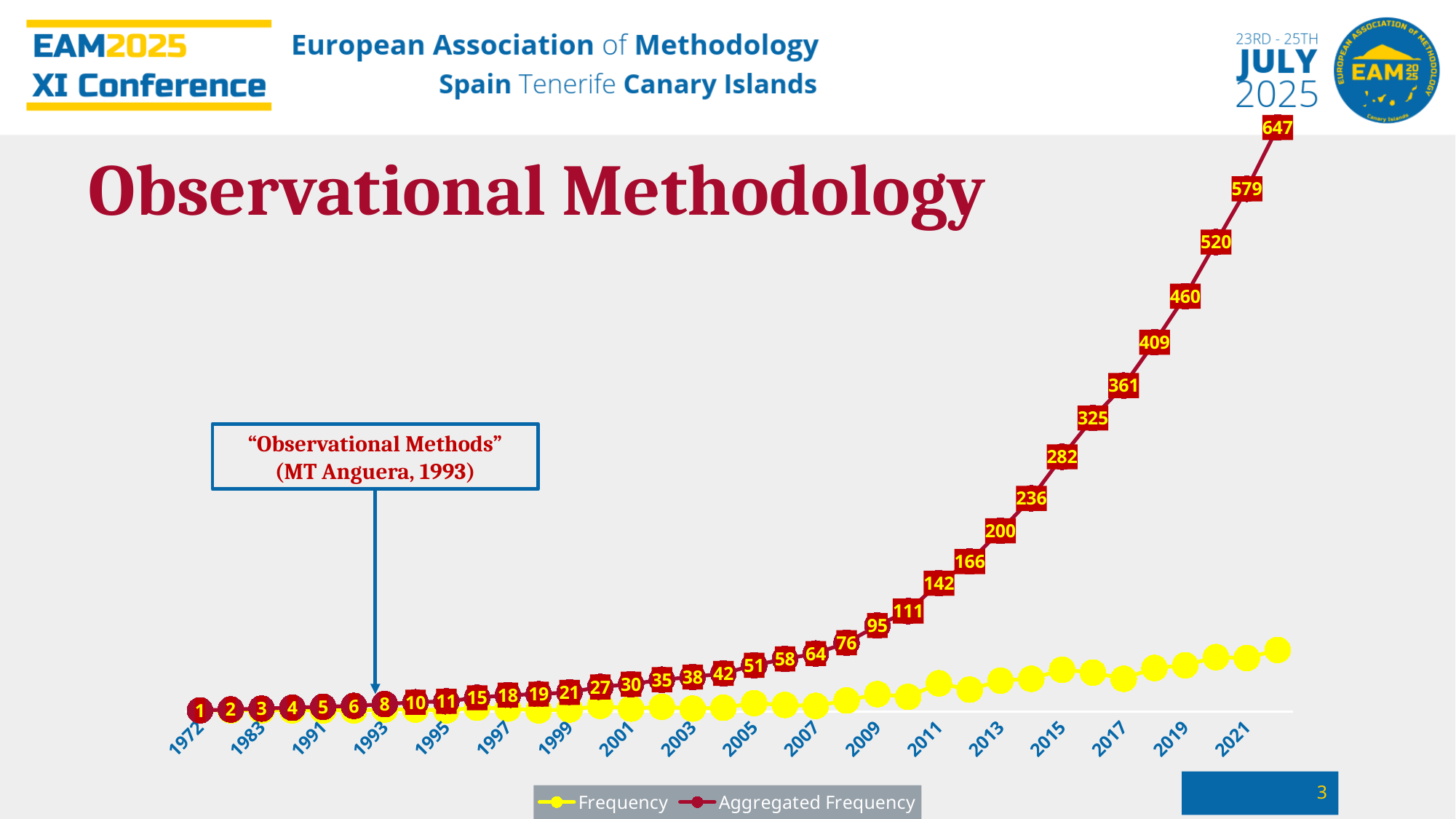
At 2021, which series has the larger value, Frequency or Aggregated Frequency? Aggregated Frequency What kind of chart is shown on the slide? line chart What is the Aggregated Frequency value at 2011? 142 What is the difference between the last two Aggregated Frequency values, 647 and 579? 68 Does the Aggregated Frequency series rise or fall along the x axis? rises How many year labels are shown on the x axis? 18 What is the Aggregated Frequency value at 1993? 8 What are the two series names listed in the legend? Frequency and Aggregated Frequency What is the lowest value shown for the Aggregated Frequency series? 1 What is the highest value shown for the Aggregated Frequency series? 647 How many series does the chart legend list? 2 What is the Aggregated Frequency value at 2021? 579